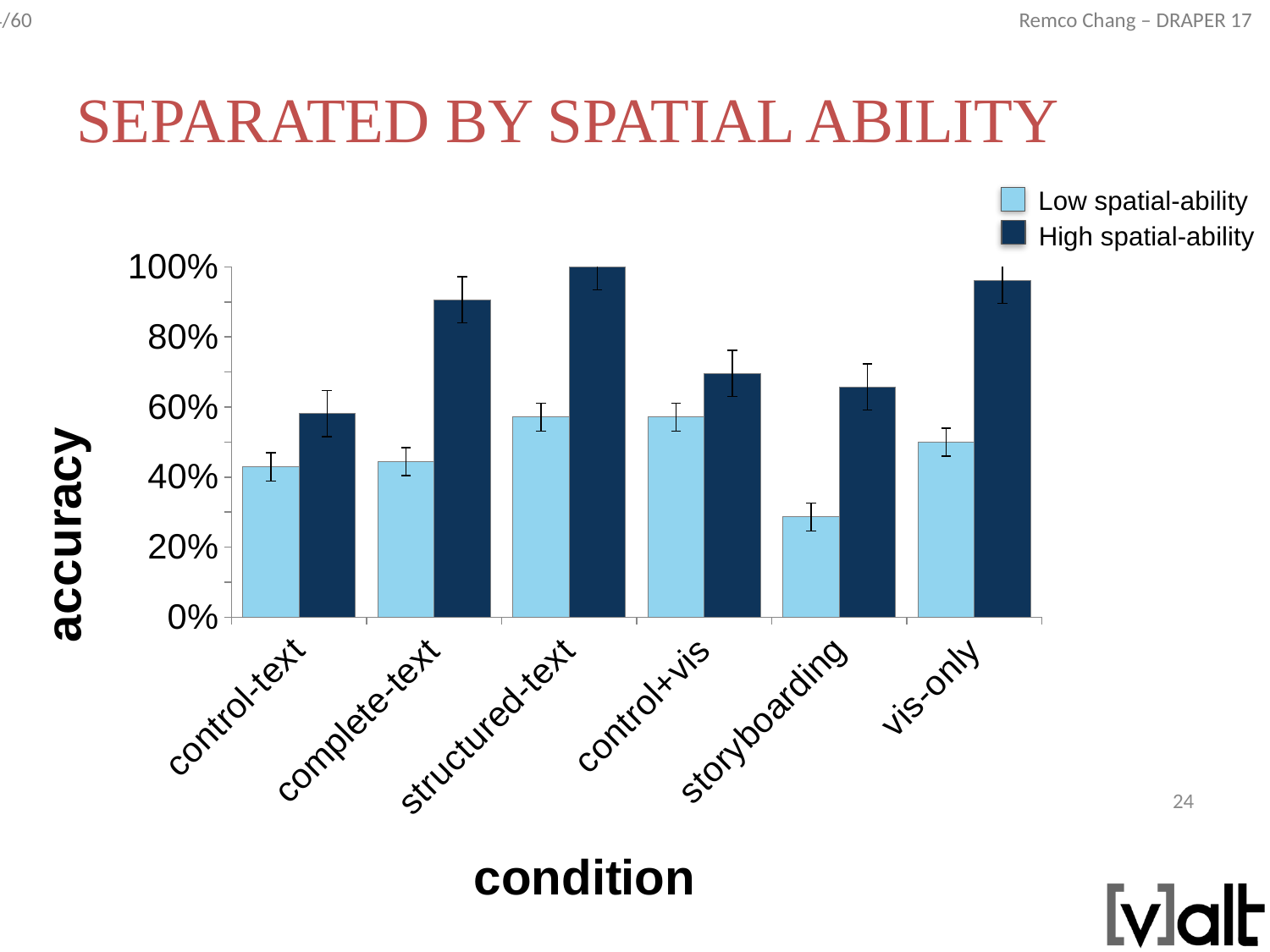
For the High spatial-ability series, which condition has the higher accuracy: control-text or complete-text? complete-text For the storyboarding condition, which series has the higher accuracy? High spatial-ability What kind of chart is shown on the slide? bar chart Is the Low spatial-ability accuracy for vis-only greater or less than 60%? less How many series does the legend list? 2 Is the Low spatial-ability accuracy for storyboarding greater or less than 40%? less Which condition has the lowest accuracy for the Low spatial-ability series? storyboarding What is the label on the y axis? accuracy What is the label on the x axis? condition Is the High spatial-ability accuracy for complete-text greater or less than 80%? greater How many conditions are shown along the x axis? 6 Which condition has the highest accuracy for the High spatial-ability series? structured-text